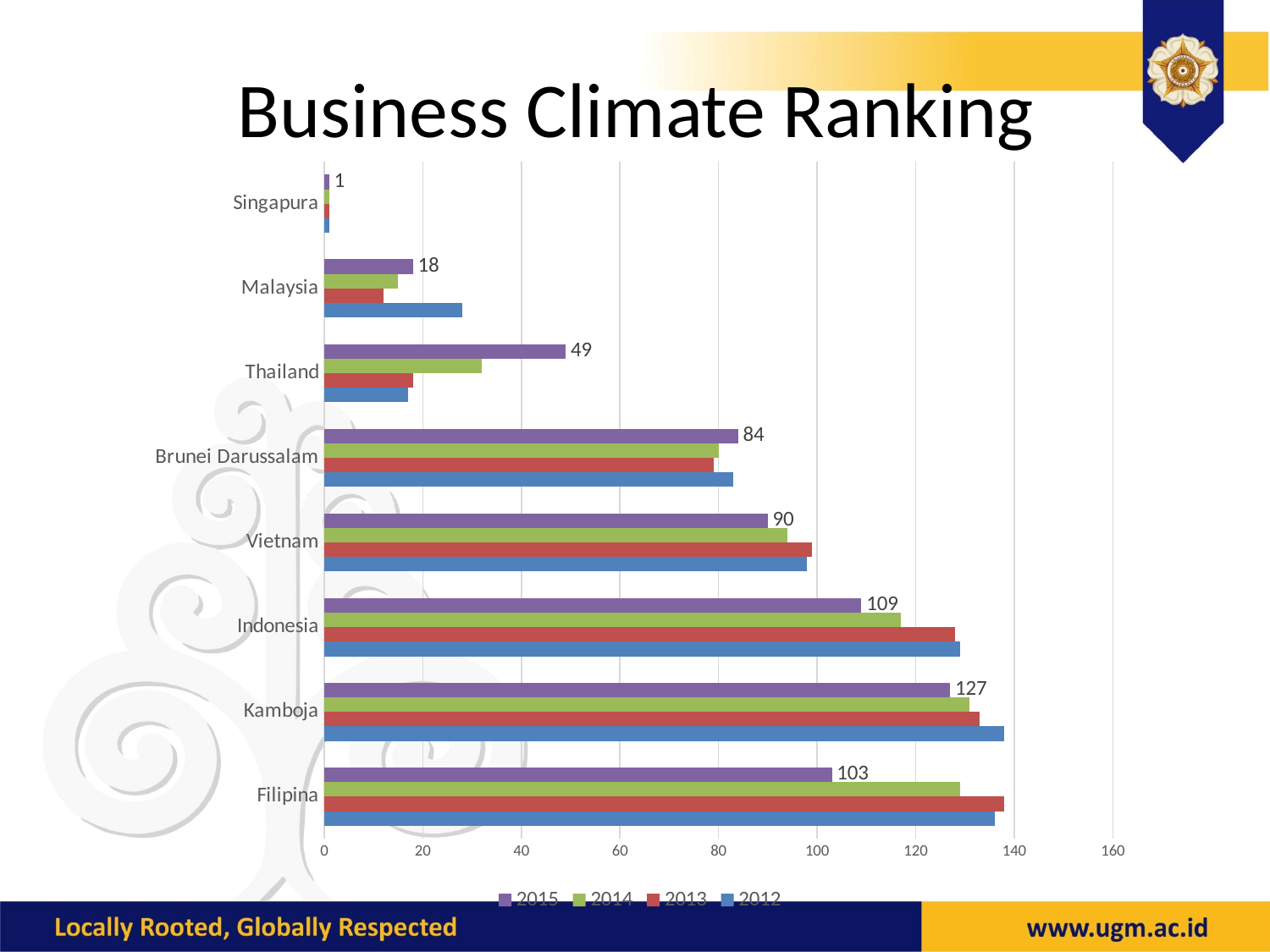
How many series does the legend list? 4 What is the difference between the 2015 values for Kamboja and Filipina? 24 Which country has the lowest 2015 value? Singapura What is the 2015 value for Thailand? 49 How many countries are shown on the chart? 8 Which has the larger 2015 value, Vietnam or Brunei Darussalam? Vietnam Is the 2012 value for Kamboja greater or less than 120? greater What is the 2015 value for Kamboja? 127 Which country has the highest 2015 value? Kamboja What is the 2015 value for Indonesia? 109 Is the 2012 value for Malaysia greater or less than 40? less What kind of chart is shown on the slide? Bar chart